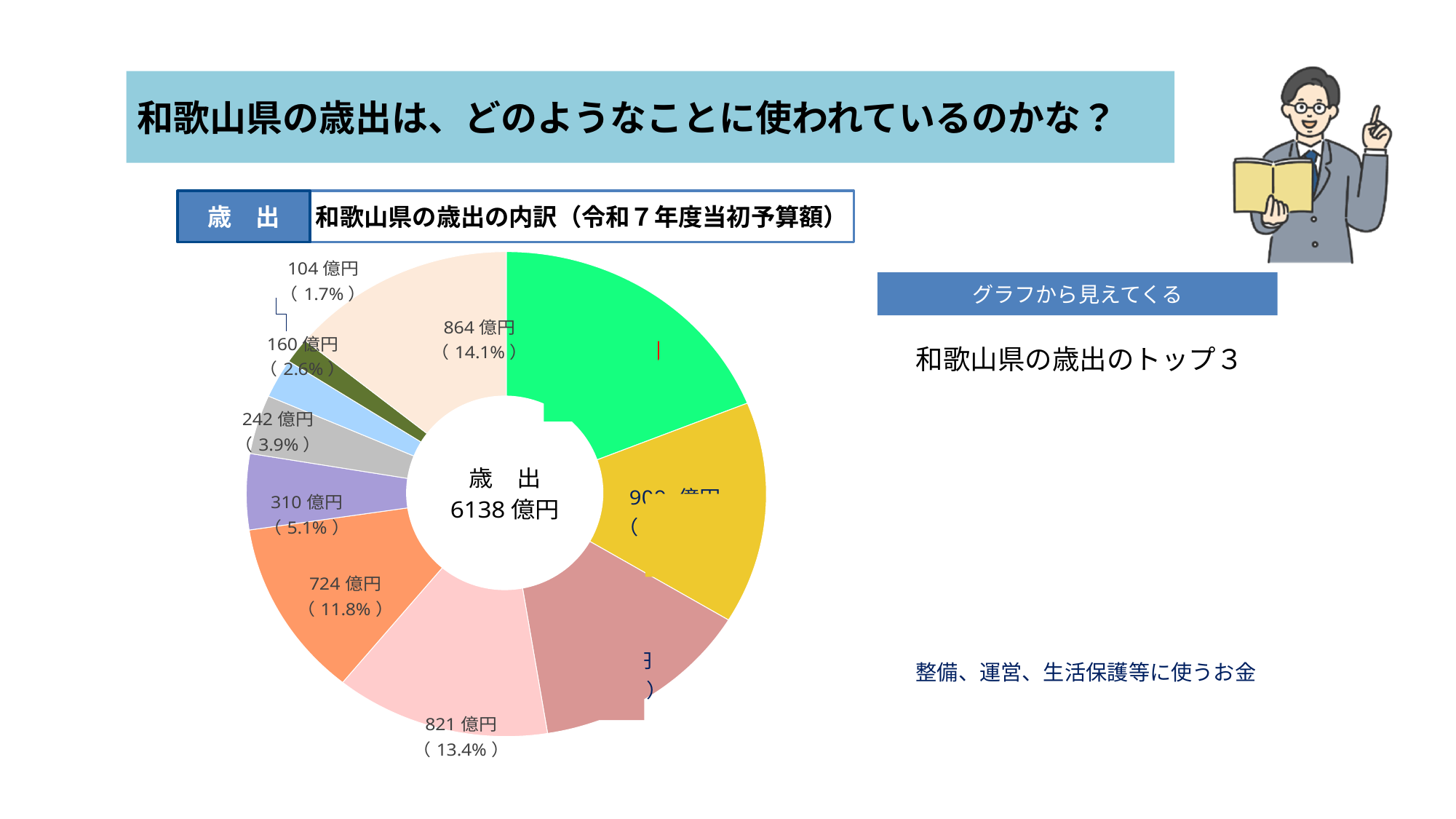
What is the difference between the 724 億円 slice and the 310 億円 slice? 414 億円 Which is larger, the 864 億円 slice or the 821 億円 slice? 864 億円 What total expenditure (歳出) is printed in the centre of the chart? 6138 億円 What share of the pie does the 821 億円 slice represent? 13.4% How many slices does the pie chart have? 10 What is the title of the chart? 和歌山県の歳出の内訳（令和７年度当初予算額） What is the value of the slice labelled 11.8%? 724 億円 What share of the pie does the 242 億円 slice represent? 3.9% Which labelled slice has the smallest value? 104 億円 What share of the pie does the 864 億円 slice represent? 14.1% What is the value of the slice labelled 5.1%? 310 億円 What kind of chart is shown on the slide? pie chart